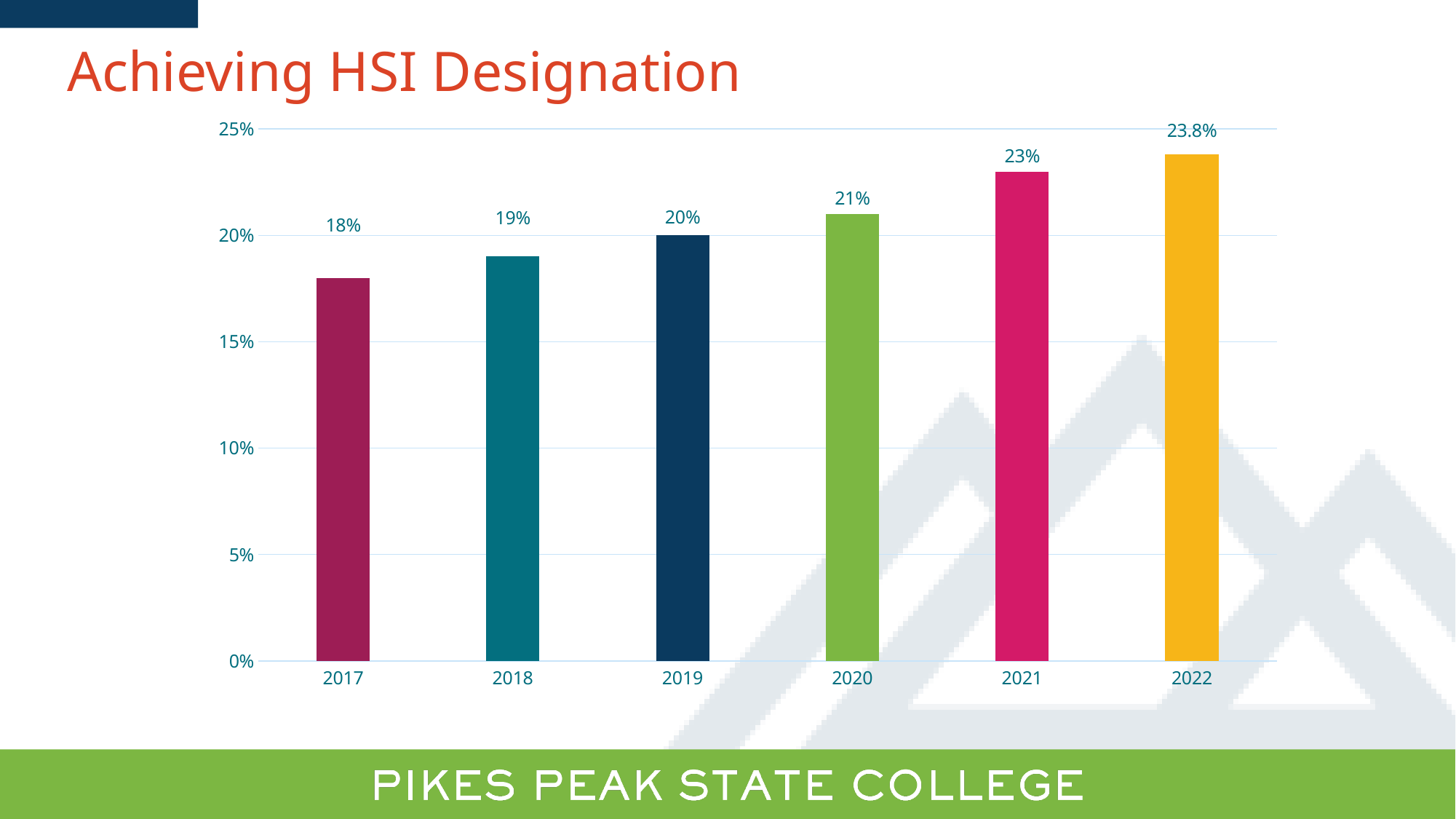
Which year has the highest value? 2022 How many years are shown on the chart? 6 What is the value for 2020? 21% Do the values rise or fall from 2017 to 2022? rise What kind of chart is shown on the slide? bar chart Which year has the lowest value? 2017 Which is larger, the value for 2018 or the value for 2020? 2020 What is the value for 2017? 18% Is the value for 2019 greater or less than 15%? greater What is the difference between the values for 2021 and 2019? 3% What is the value for 2022? 23.8% What is the difference between the values for 2022 and 2017? 5.8%